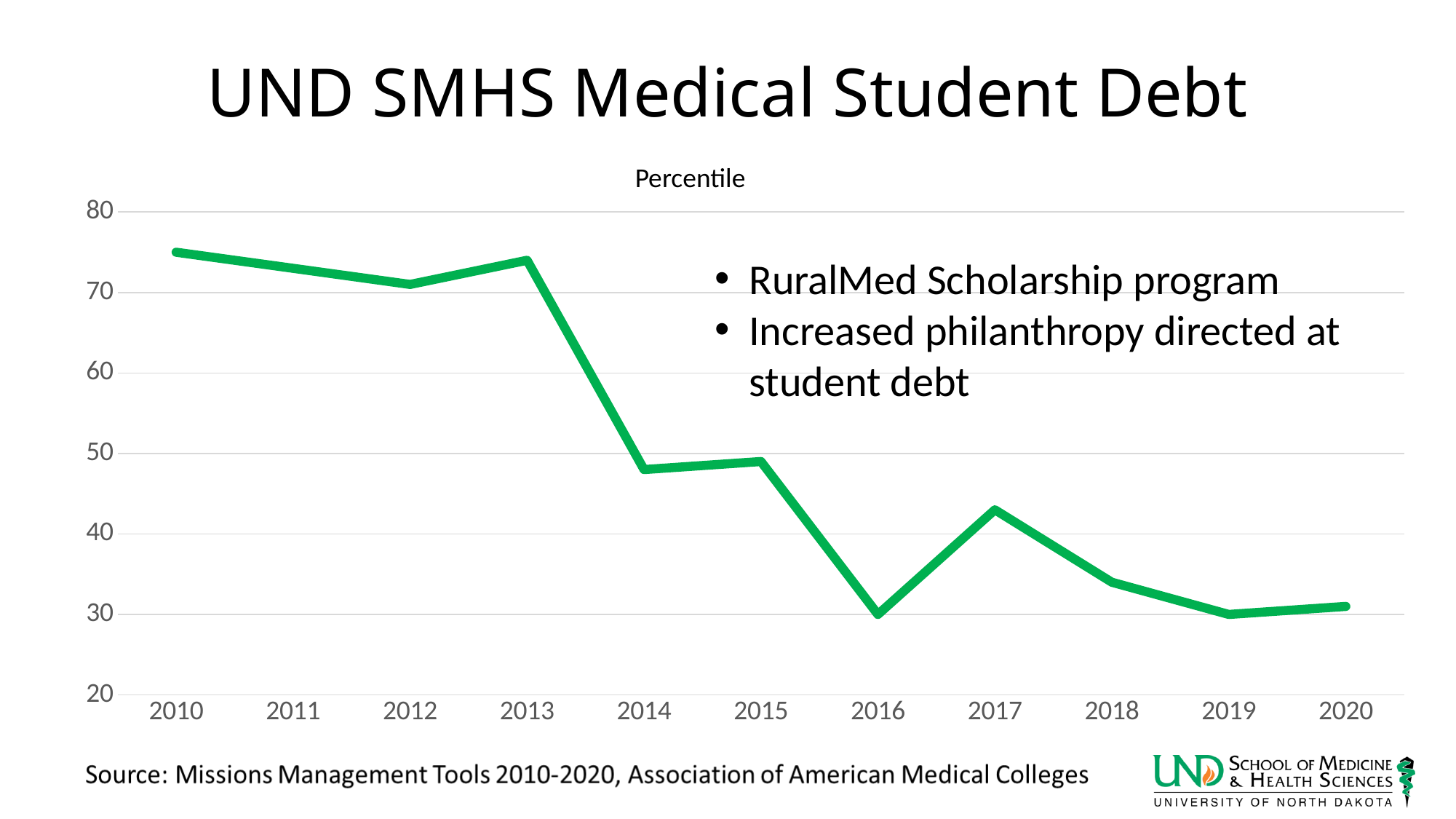
Is the value for 2020 greater or less than 40? less Which year has the larger value, 2013 or 2014? 2013 What colour is the line in the chart? green What kind of chart is shown on the slide? line chart What is the title shown above the chart's plot area? Percentile Is the value for 2017 greater or less than 40? greater Is the value for 2016 greater or less than 40? less Which year has the larger value, 2017 or 2018? 2017 Overall, do the values rise or fall from 2010 to 2020? fall How many years are plotted along the x axis of the chart? 11